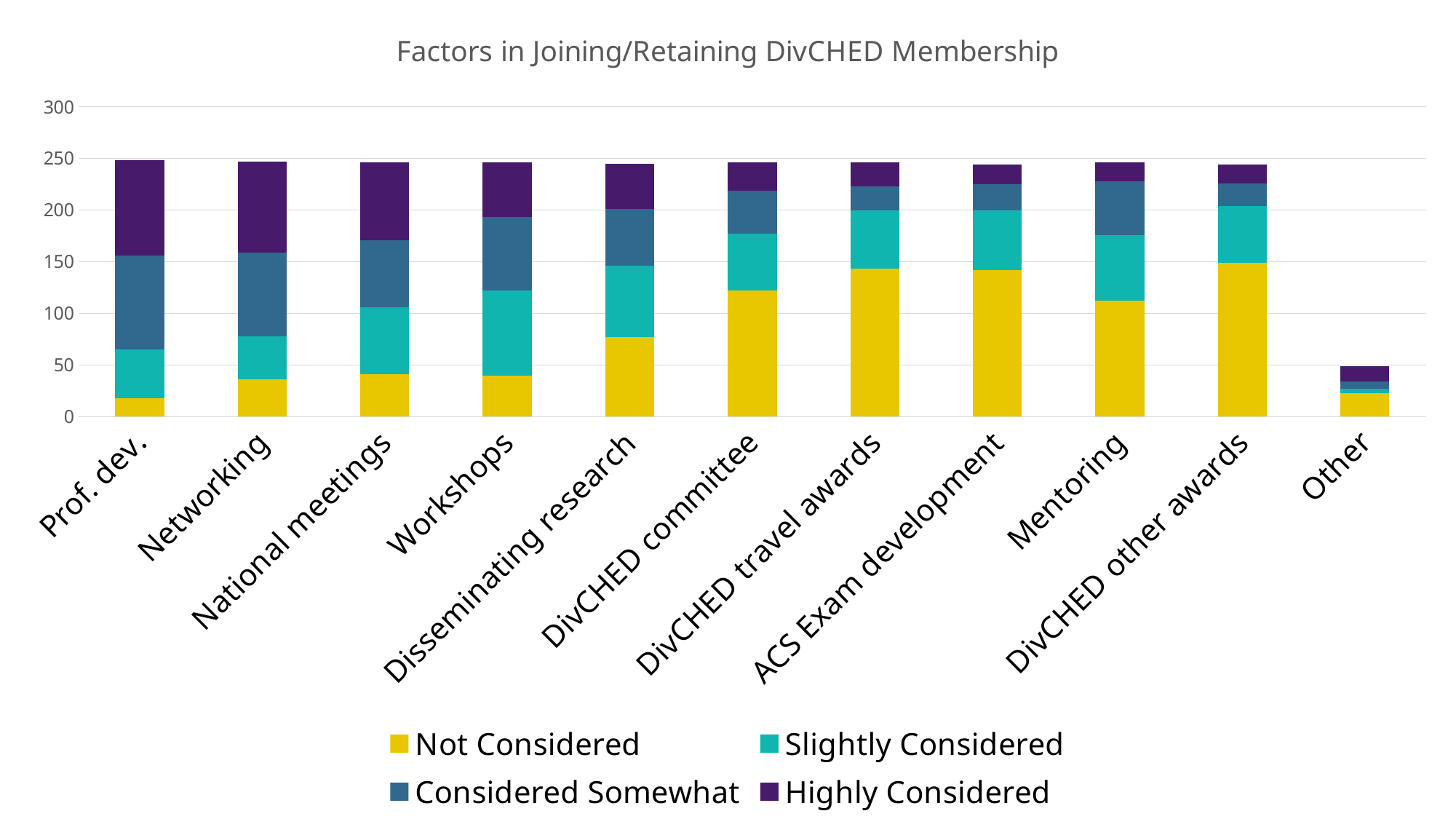
Which has the larger Highly Considered value, Prof. dev. or Other? Prof. dev. How many categories are shown on the x axis of the chart? 11 What is the title of the chart? Factors in Joining/Retaining DivCHED Membership Is the total stacked bar for Other greater or less than 100? less Which series is shown in yellow in the legend? Not Considered Is the Not Considered value for DivCHED other awards greater or less than 100? greater Which has the larger Not Considered value, Prof. dev. or DivCHED other awards? DivCHED other awards Is the Not Considered value for Prof. dev. greater or less than 50? less Which category has the lowest total stacked bar? Other How many series does the legend list? 4 What kind of chart is shown on the slide? Stacked bar chart